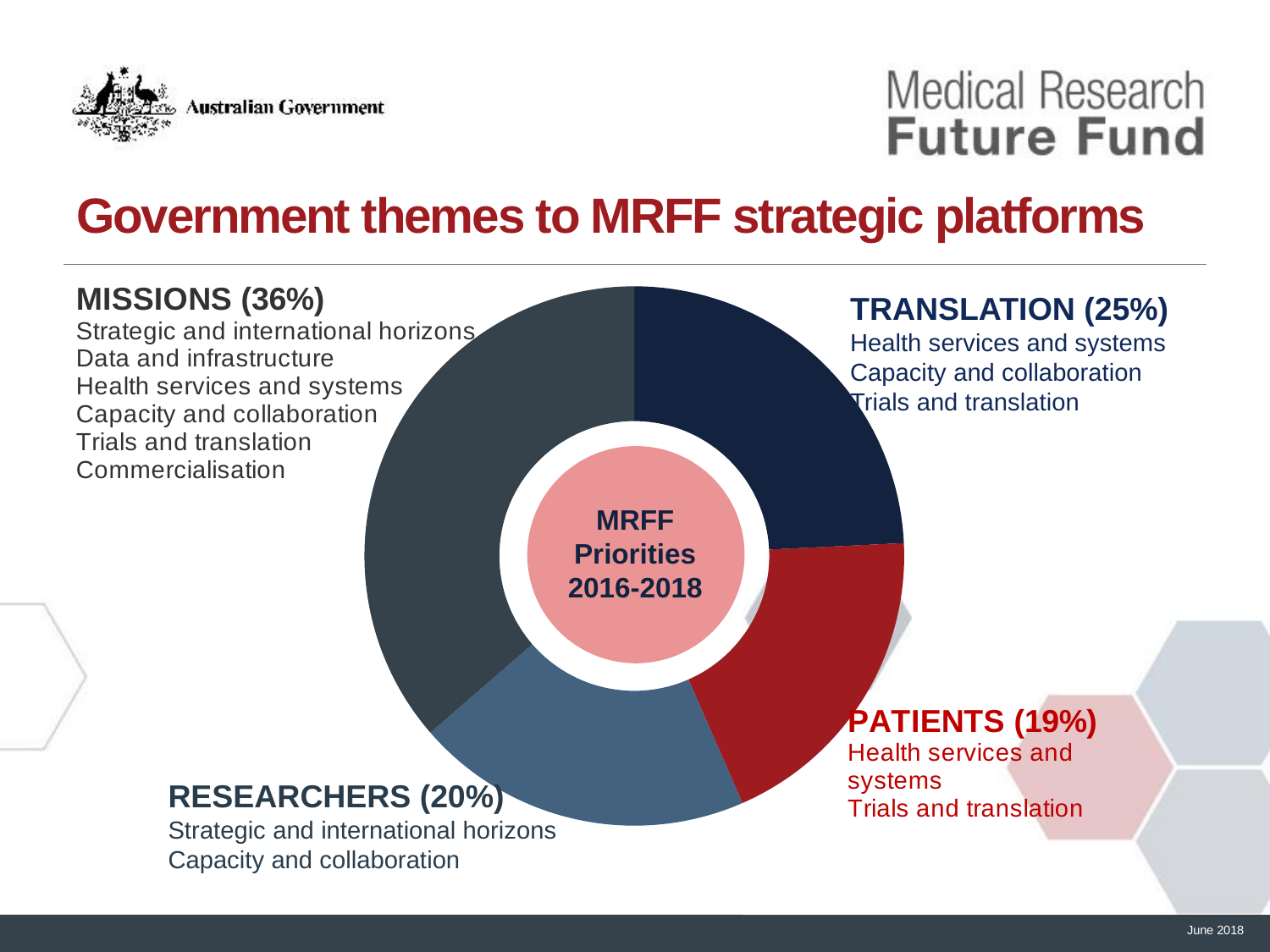
What percentage share does the Patients segment have in the donut chart? 19% What text appears in the centre of the donut chart? MRFF Priorities 2016-2018 Which segment of the donut chart has the smallest share? Patients How many segments does the donut chart have? 4 What percentage share does the Missions segment have in the donut chart? 36% What kind of chart is shown on the slide? Donut (pie) chart What percentage share does the Translation segment have in the donut chart? 25% What is the difference in percentage points between the Missions and Translation segments? 11 Which segment of the donut chart has the largest share? Missions What percentage share does the Researchers segment have in the donut chart? 20% Which segment is larger, Translation or Researchers? Translation What is the difference in percentage points between the Researchers and Patients segments? 1